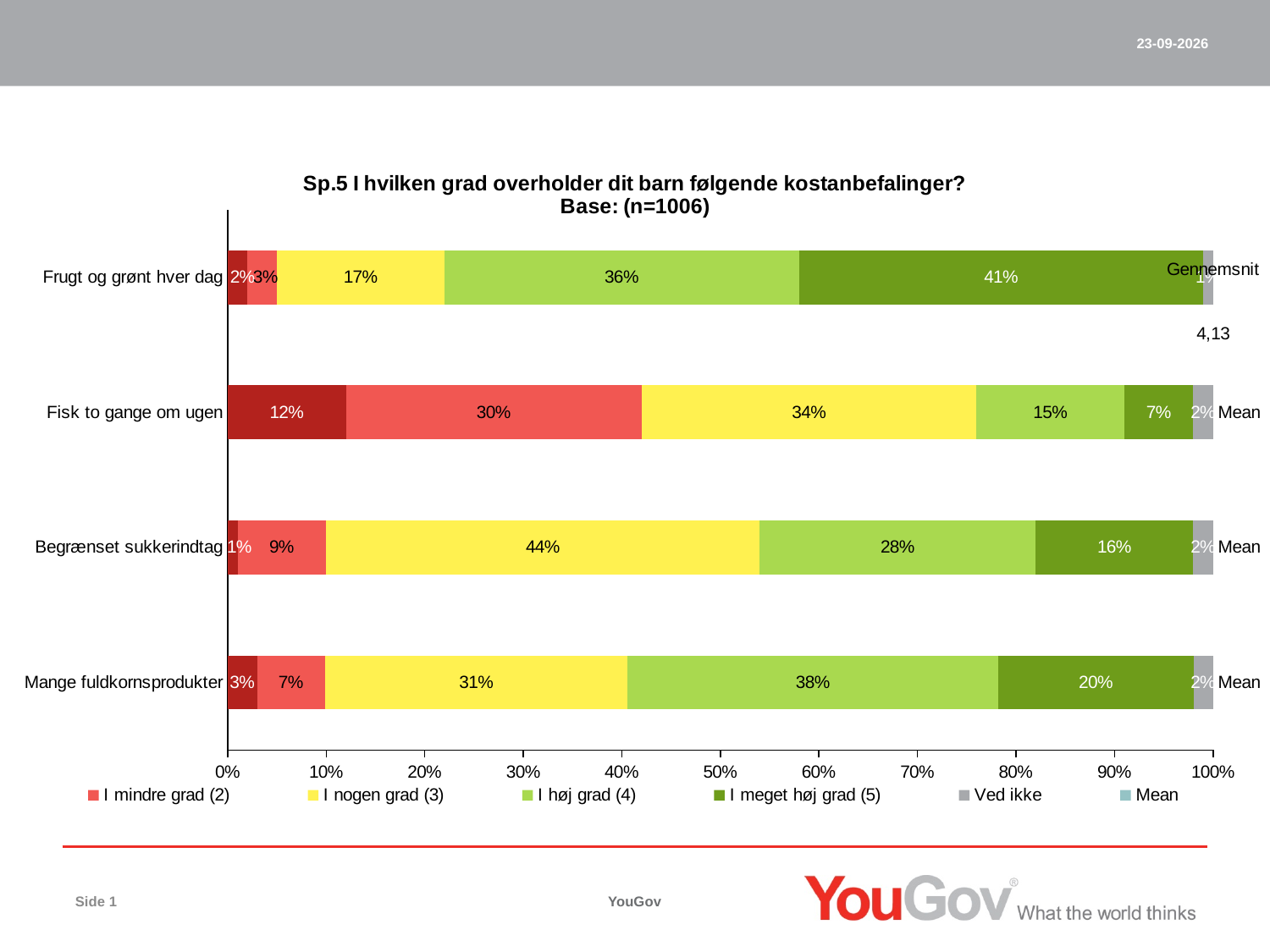
What kind of chart is shown on the slide? Stacked bar chart Which category has the highest 'I meget høj grad (5)' share? Frugt og grønt hver dag Which has the larger 'I høj grad (4)' value: 'Frugt og grønt hver dag' or 'Mange fuldkornsprodukter'? Mange fuldkornsprodukter What percentage answered 'I meget høj grad (5)' for 'Frugt og grønt hver dag'? 41% Which category has the highest 'I mindre grad (2)' share? Fisk to gange om ugen Which category has the lowest 'I meget høj grad (5)' share? Fisk to gange om ugen How many percentage points higher is the 'I nogen grad (3)' value for 'Begrænset sukkerindtag' than for 'Fisk to gange om ugen'? 10 percentage points What is the 'I høj grad (4)' value for 'Mange fuldkornsprodukter'? 38% What percentage answered 'I nogen grad (3)' for 'Begrænset sukkerindtag'? 44% What is the 'Ved ikke' value for 'Mange fuldkornsprodukter'? 2% How many categories (dietary recommendations) are shown on the chart? 4 What is the 'I mindre grad (2)' value for 'Fisk to gange om ugen'? 30%